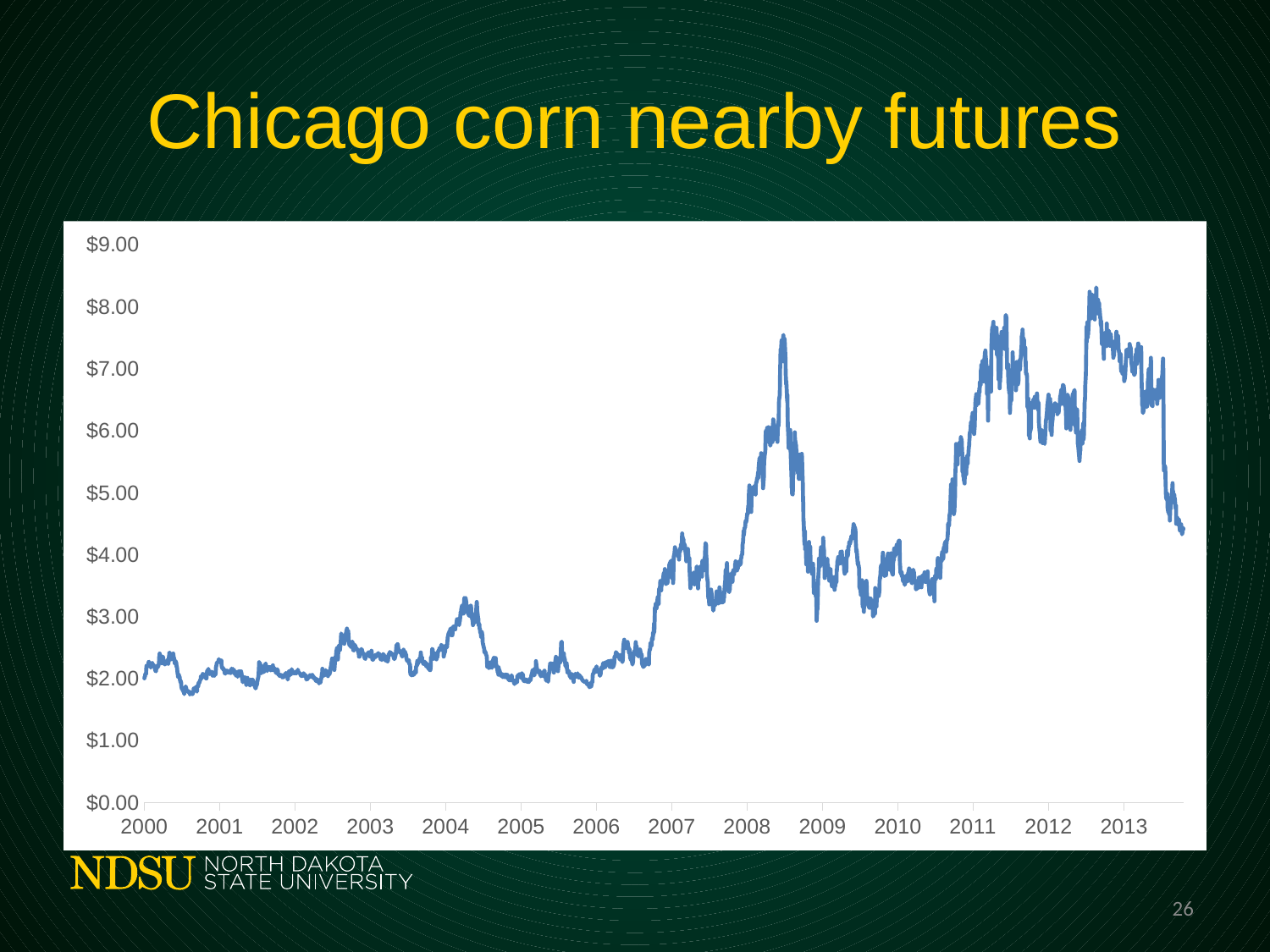
Is the price at the start of 2000 greater or less than $3.00? less Is the highest price reached in 2012 greater or less than $8.00? greater What is the first year labeled on the x axis? 2000 Overall, do corn futures prices rise or fall from 2000 to 2013? rise Is the price during 2005 greater or less than $3.00? less How many years are labeled on the x axis? 14 What kind of chart is shown on the slide? line chart What is the title of the chart? Chicago corn nearby futures Which peak is higher, the one in 2008 or the one in 2012? 2012 In which year does the line reach its highest point? 2012